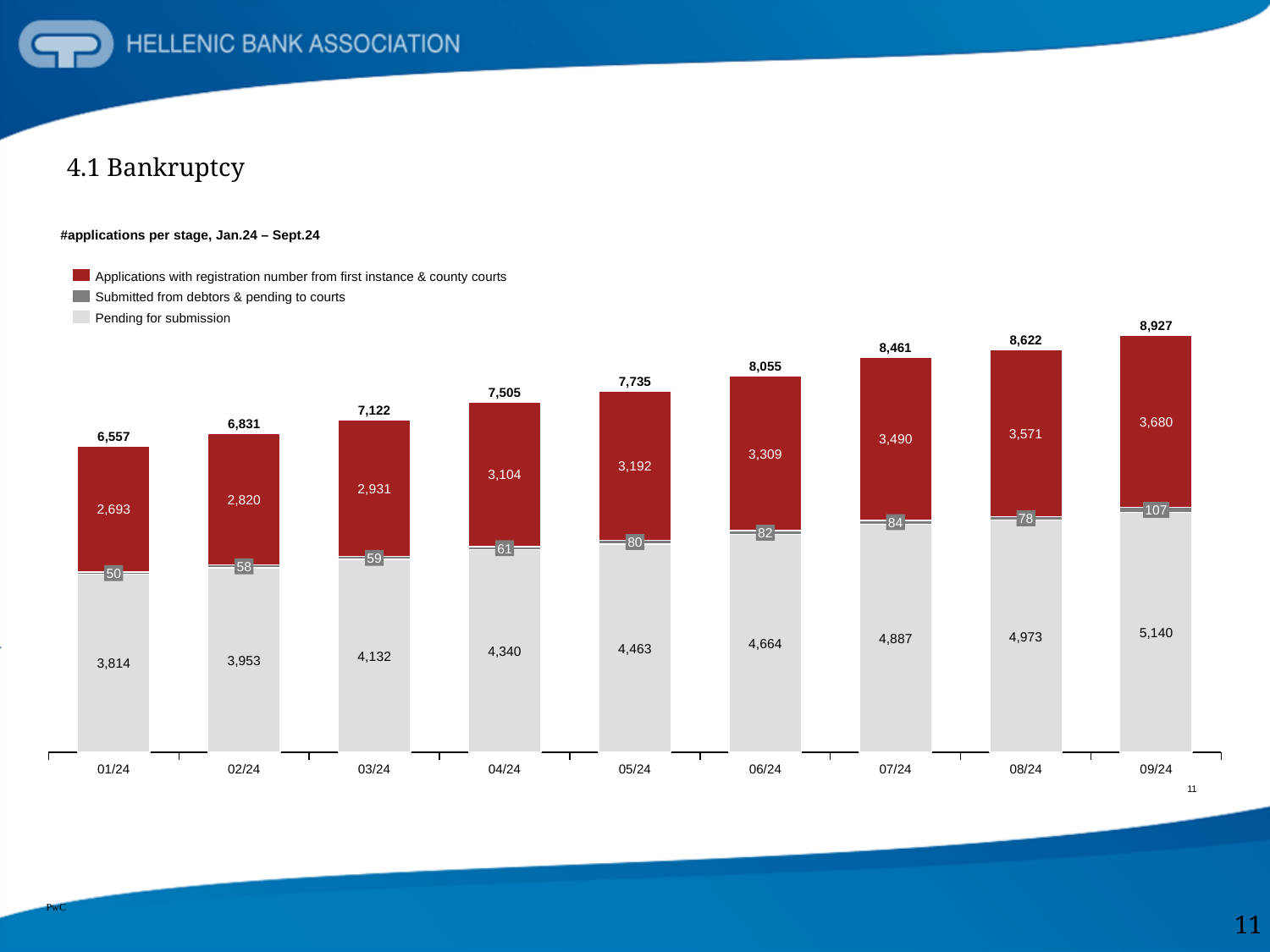
How many months are shown on the x axis? 9 What is the value of 'Pending for submission' for 01/24? 3,814 What is the value of 'Applications with registration number from first instance & county courts' for 09/24? 3,680 What is the total of the stacked bar for 06/24? 8,055 Which month has the lowest value for 'Submitted from debtors & pending to courts'? 01/24 What is the difference between the total for 09/24 and the total for 01/24? 2,370 Do the total values rise or fall from 01/24 to 09/24? Rise Which is larger: 'Pending for submission' for 04/24 or 'Applications with registration number from first instance & county courts' for 04/24? Pending for submission for 04/24 What is the value of 'Submitted from debtors & pending to courts' for 05/24? 80 How many series does the legend list? 3 What kind of chart is shown on the slide? Stacked bar chart Which month has the highest total number of applications? 09/24